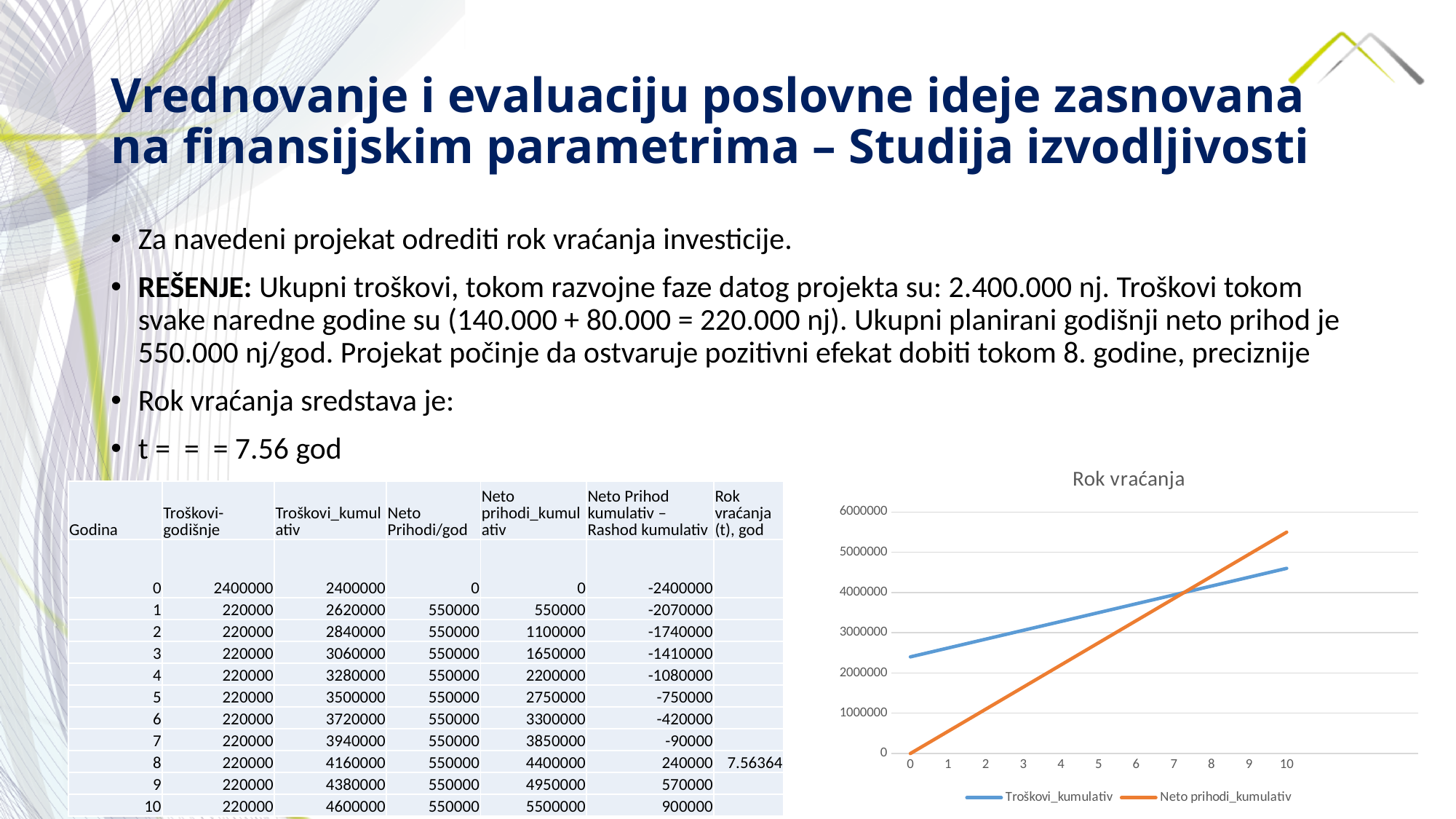
How many series does the chart's legend list? 2 At x = 10, which series has the higher value, Troškovi_kumulativ or Neto prihodi_kumulativ? Neto prihodi_kumulativ Is the value of Neto prihodi_kumulativ at x = 10 greater or less than 5000000? greater Is the value of Troškovi_kumulativ at x = 0 greater or less than 2000000? greater What kind of chart is shown on the slide? line chart Is the value of Neto prihodi_kumulativ at x = 3 greater or less than 2000000? less What is the value of Neto prihodi_kumulativ at x = 0 in the chart? 0 Which colour is used for the Neto prihodi_kumulativ series in the chart? orange What is the title of the chart? Rok vraćanja Does the Neto prihodi_kumulativ line rise or fall as the x axis goes from 0 to 10? rise How many points along the x axis does each line in the chart cover? 11